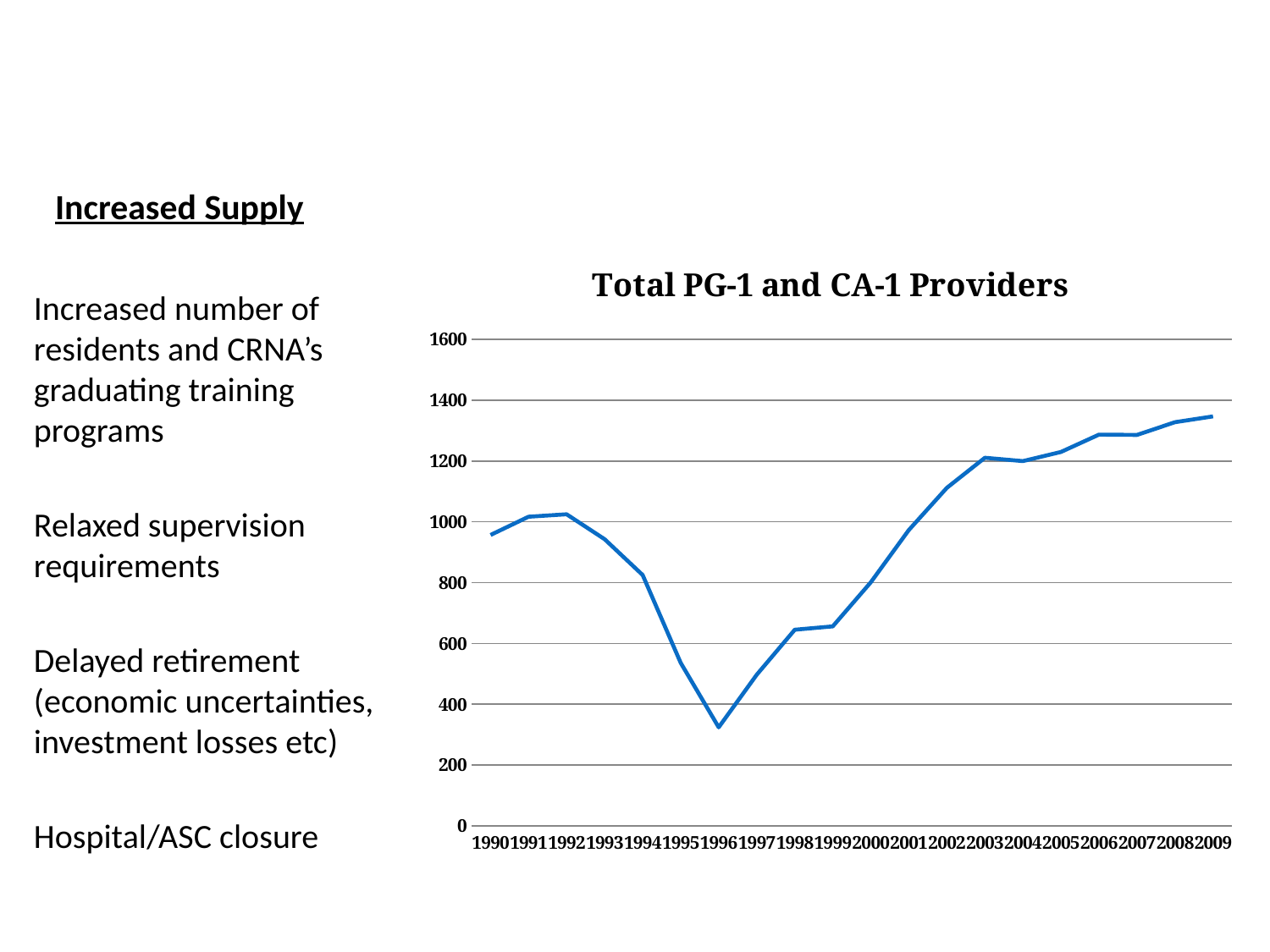
What is the title of the chart? Total PG-1 and CA-1 Providers Is the value for 1990 greater or less than 1000? less What kind of chart is shown on the slide? line chart Which year has the larger value, 1990 or 1996? 1990 How many years are plotted along the x axis of the chart? 20 In which year is the value of Total PG-1 and CA-1 Providers highest? 2009 Do the values rise or fall from 1996 to 2003? rise Is the value for 1996 greater or less than 400? less Is the value for 2002 greater or less than 1000? greater Which year has the larger value, 1994 or 2003? 2003 In which year is the value of Total PG-1 and CA-1 Providers lowest? 1996